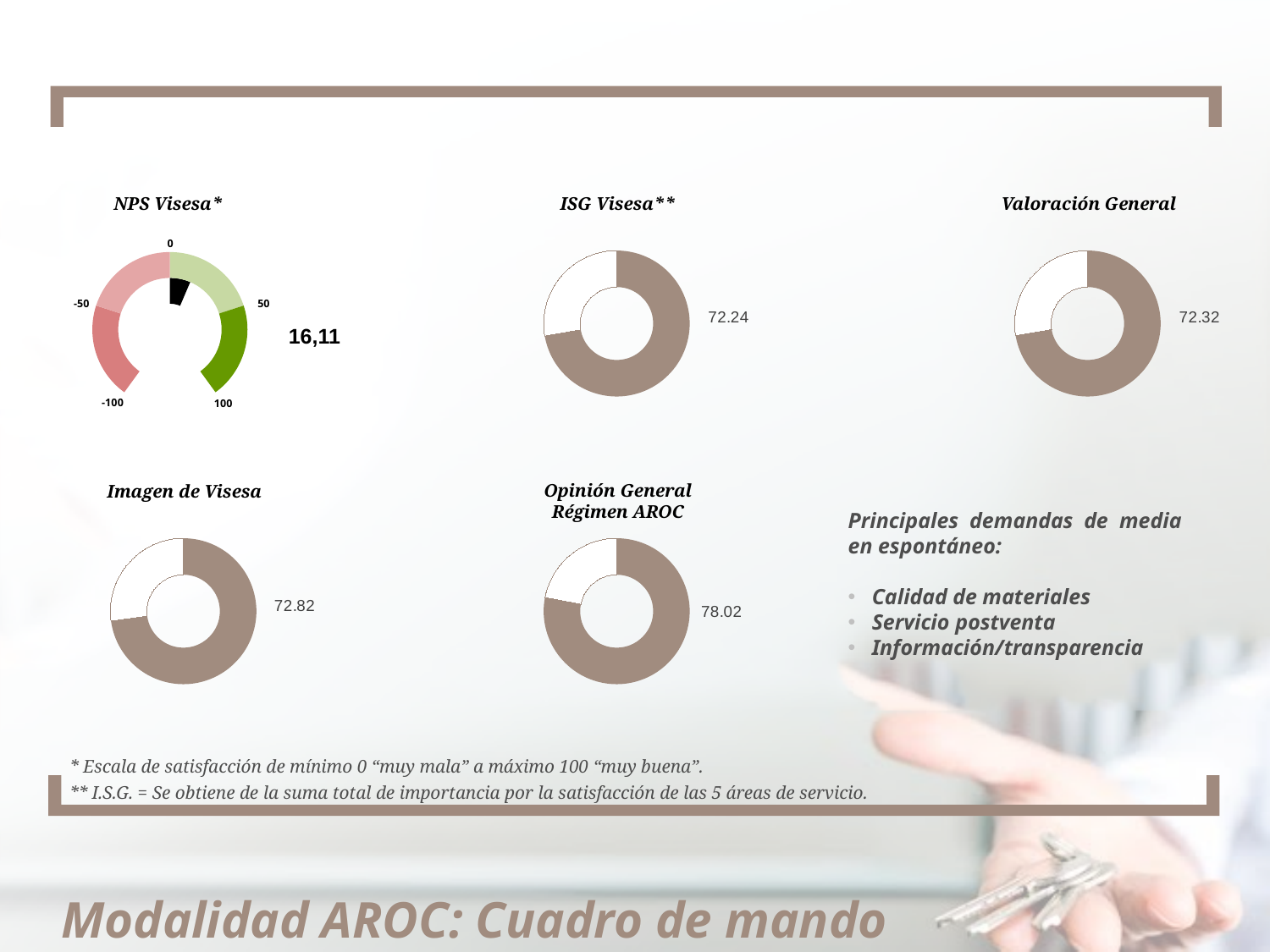
Which of the four donut charts shows the highest value? Opinión General Régimen AROC Which of the four donut charts shows the lowest value? ISG Visesa** What value is shown on the NPS Visesa* gauge chart? 16,11 What kind of chart is the NPS Visesa* chart? gauge chart What are the minimum and maximum values labelled on the NPS Visesa* gauge? -100 and 100 What value is shown on the Valoración General donut chart? 72.32 Which is larger, the Imagen de Visesa value or the Valoración General value? Imagen de Visesa What kind of chart is the ISG Visesa** chart? donut chart What value is shown on the ISG Visesa** donut chart? 72.24 What value is shown on the Opinión General Régimen AROC donut chart? 78.02 What value is shown on the Imagen de Visesa donut chart? 72.82 What is the difference between the Opinión General Régimen AROC value and the ISG Visesa** value? 5.78